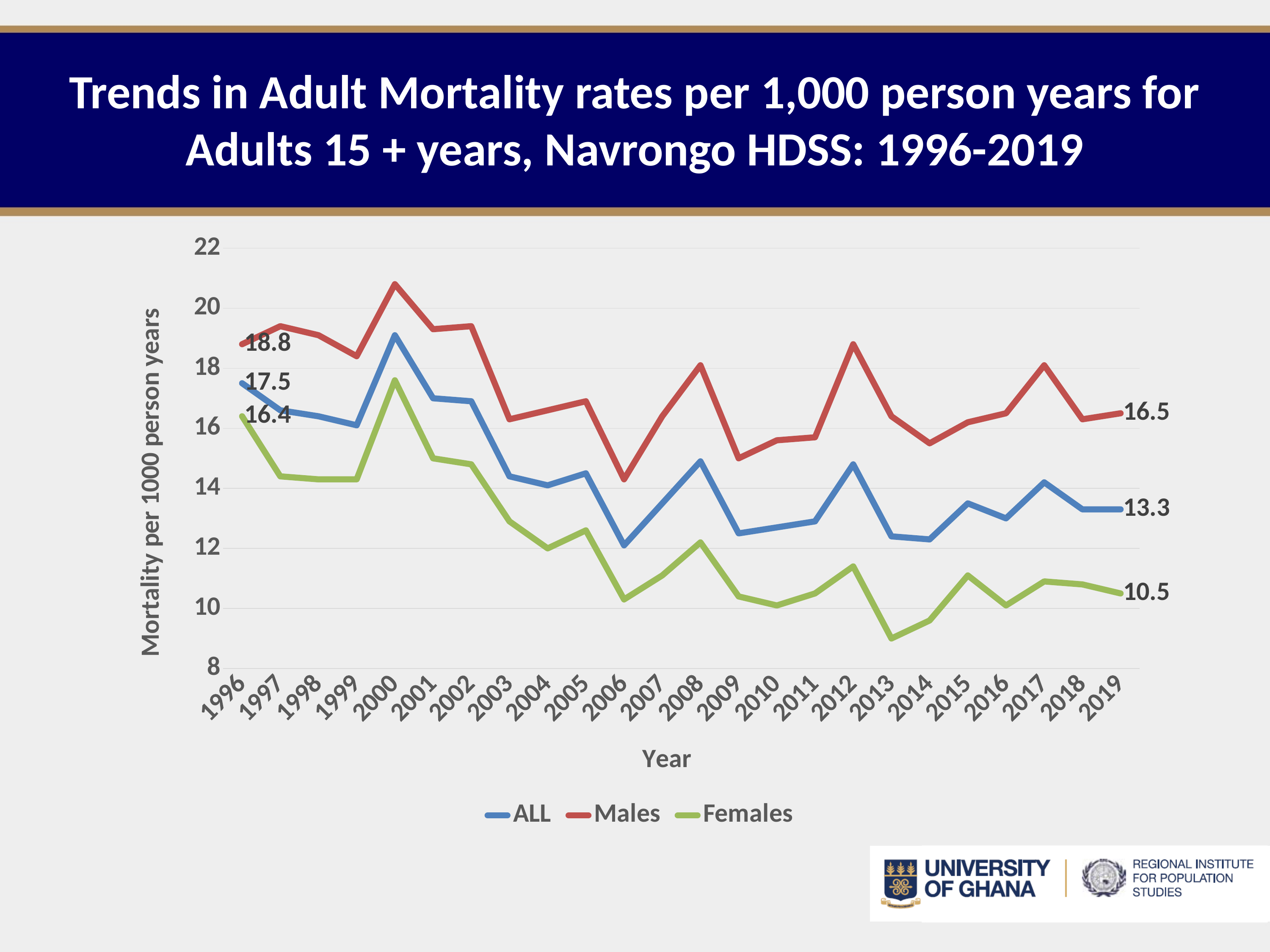
Is the Males mortality rate in 2000 greater or less than 20? greater What is the mortality rate for ALL in 2019? 13.3 By how much did the Males mortality rate change from 1996 to 2019? 2.3 How many series does the legend list? 3 What is the mortality rate for Males in 1996? 18.8 Which series has the lowest mortality rate in 2013? Females What kind of chart is shown on the slide? Line chart What is the difference between the Males and Females mortality rates in 2019? 6.0 Which series has the highest mortality rate in 2000? Males Is the Females mortality rate in 2013 greater or less than 10? less What is the mortality rate for Females in 2019? 10.5 What is the mortality rate for Females in 1996? 16.4